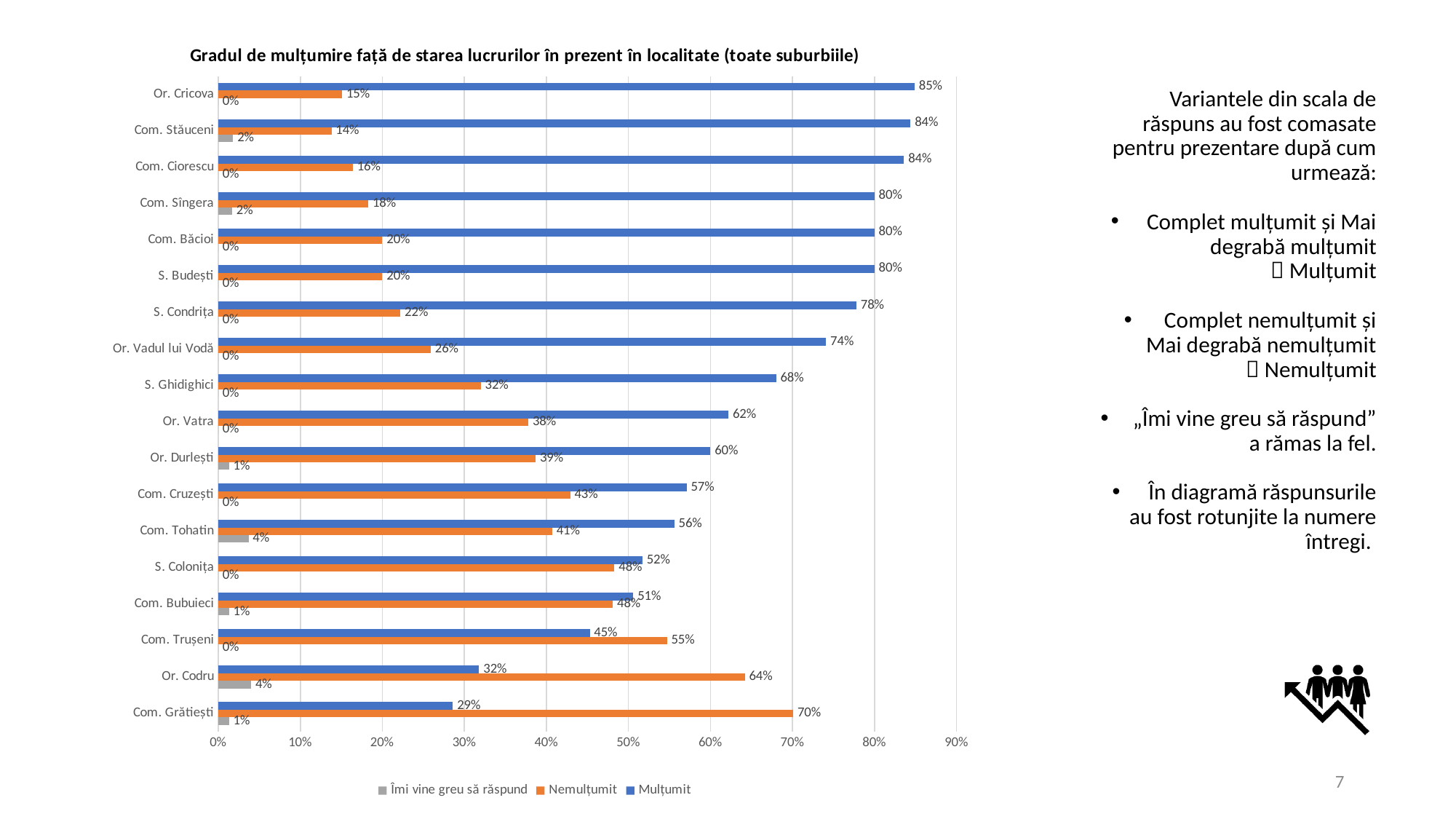
Which locality has the highest Mulțumit value? Or. Cricova How many localities are shown on the chart? 18 What is the Îmi vine greu să răspund value for Com. Tohatin? 4% Which locality has the lowest Mulțumit value? Com. Grătiești What is the Mulțumit value for Or. Vadul lui Vodă? 74% Which locality has the highest Nemulțumit value? Com. Grătiești What kind of chart is shown on the slide? Bar chart What is the Nemulțumit value for Com. Cruzești? 43% How many series does the legend list? 3 Which colour represents the Nemulțumit series? Orange What is the difference between the Mulțumit and Nemulțumit values for Or. Codru? 32% Which is larger for Com. Trușeni: the Mulțumit value or the Nemulțumit value? Nemulțumit